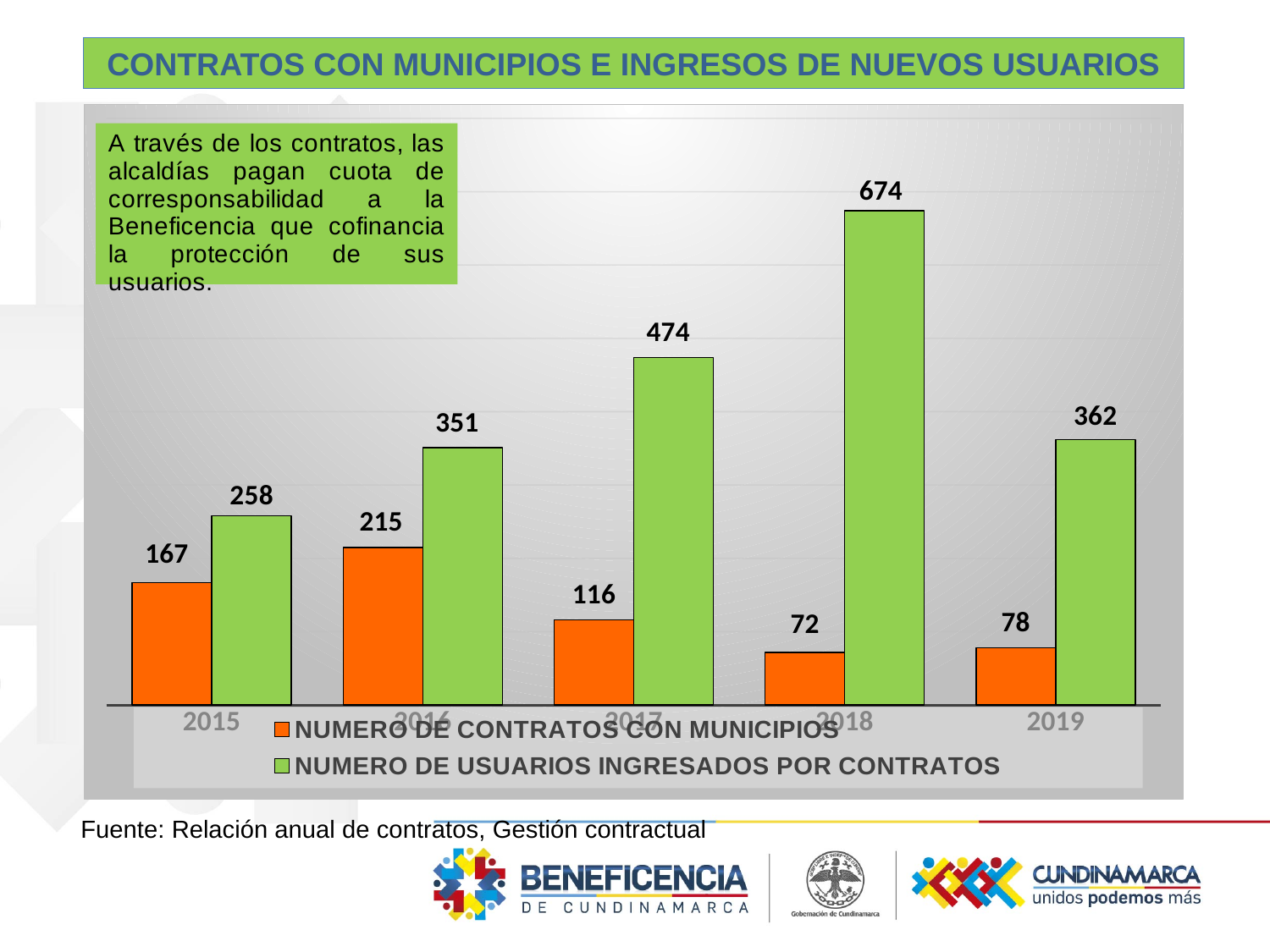
In which year is NUMERO DE CONTRATOS CON MUNICIPIOS lowest? 2018 What type of chart is shown on the slide? bar chart Which colour represents NUMERO DE USUARIOS INGRESADOS POR CONTRATOS? green What is the value of NUMERO DE CONTRATOS CON MUNICIPIOS for 2019? 78 What is the value of NUMERO DE USUARIOS INGRESADOS POR CONTRATOS for 2018? 674 In which year is NUMERO DE USUARIOS INGRESADOS POR CONTRATOS highest? 2018 What is the difference between NUMERO DE USUARIOS INGRESADOS POR CONTRATOS in 2018 and in 2019? 312 Which is larger: NUMERO DE CONTRATOS CON MUNICIPIOS in 2015 or in 2019? 2015 What is the value of NUMERO DE CONTRATOS CON MUNICIPIOS for 2015? 167 Does NUMERO DE CONTRATOS CON MUNICIPIOS rise or fall from 2016 to 2018? fall How many years are shown on the x axis? 5 How many series does the legend list? 2